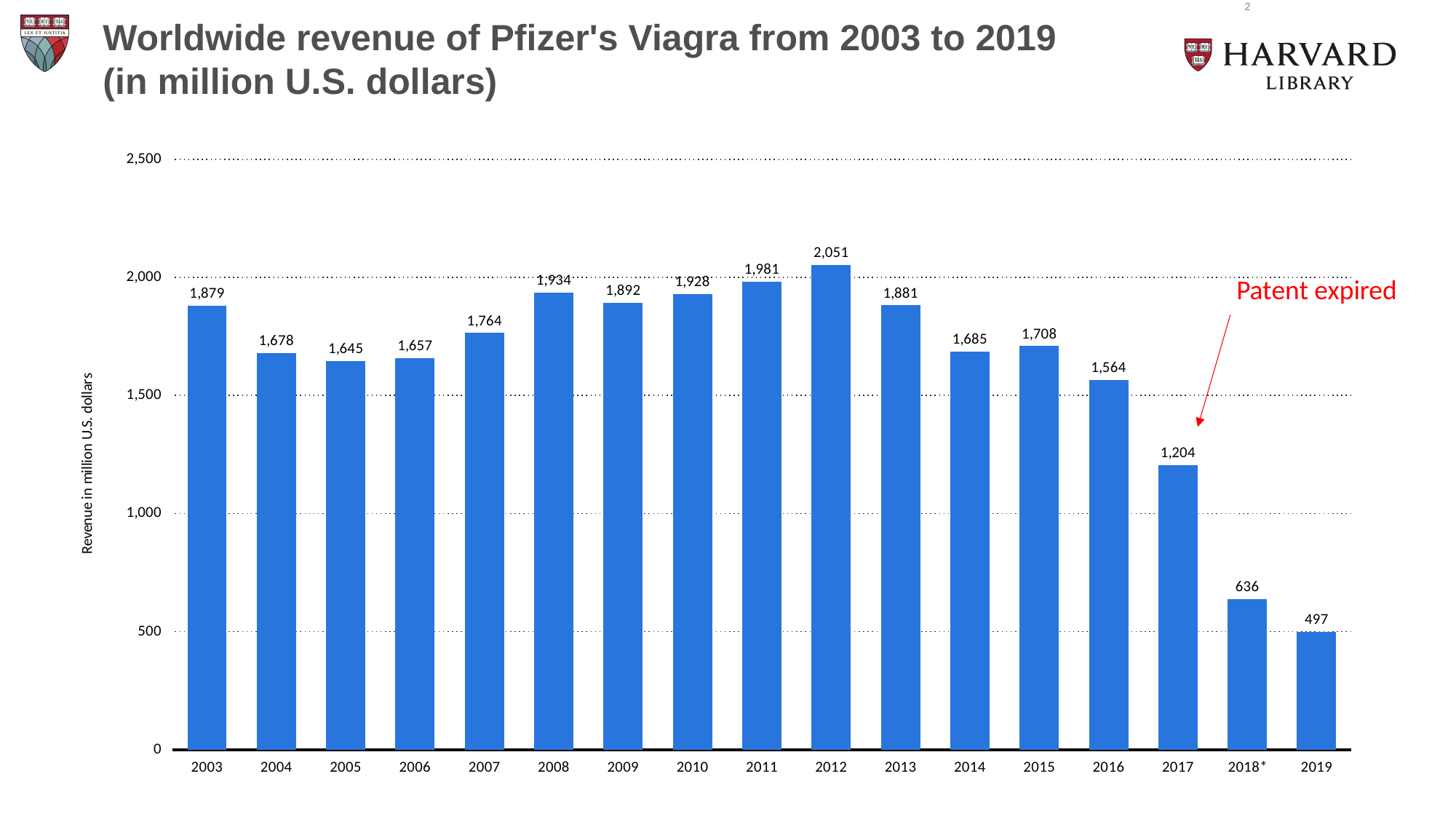
Which year had the lowest Viagra revenue? 2019 How many years are shown on the x axis of the chart? 17 What event does the red annotation on the chart point to? Patent expired What was the worldwide revenue of Pfizer's Viagra in 2003? 1,879 What was the worldwide revenue of Pfizer's Viagra in 2012? 2,051 What kind of chart is shown on the slide? bar chart Is the value for 2016 greater or less than 1,500? greater What was the worldwide revenue of Pfizer's Viagra in 2017? 1,204 Which year had the highest Viagra revenue? 2012 Which year had higher revenue, 2008 or 2010? 2008 Do the revenue values rise or fall from 2012 to 2019? fall What is the difference in revenue between 2017 and 2018*? 568